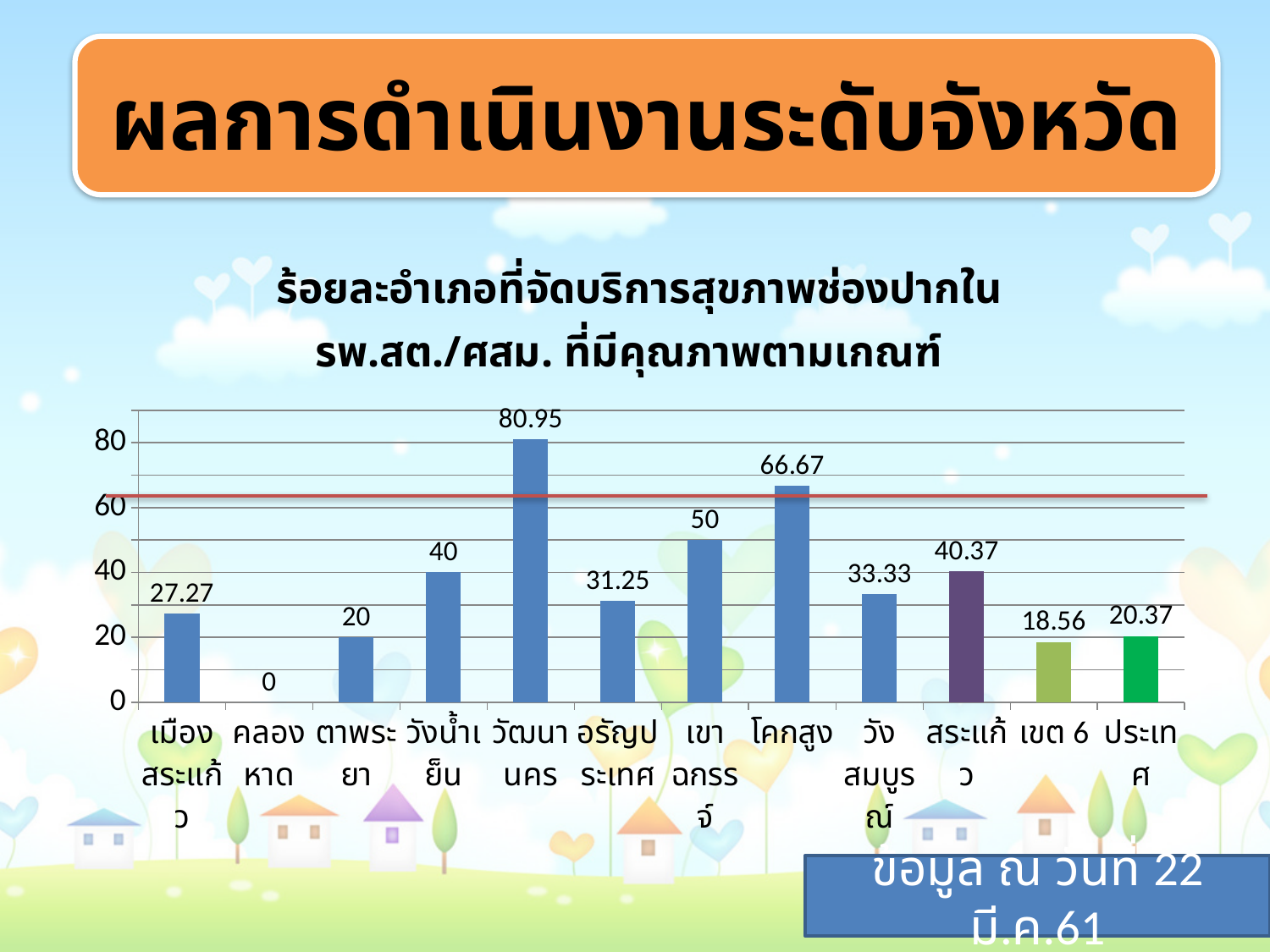
What is the value for วัฒนานคร? 80.95 What is the value for โคกสูง? 66.67 Which category has the lowest value? คลองหาด What is the value for เขต 6? 18.56 What is the title of the chart? ร้อยละอำเภอที่จัดบริการสุขภาพช่องปากใน รพ.สต./ศสม. ที่มีคุณภาพตามเกณฑ์ What is the difference between the values for ประเทศ and เขต 6? 1.81 Which is larger, the value for เขาฉกรรจ์ or the value for วังน้ำเย็น? เขาฉกรรจ์ What kind of chart is shown on the slide? Bar chart What is the value for สระแก้ว? 40.37 Which category has the highest value? วัฒนานคร How many categories are shown on the x axis? 12 What is the difference between the values for วัฒนานคร and โคกสูง? 14.28